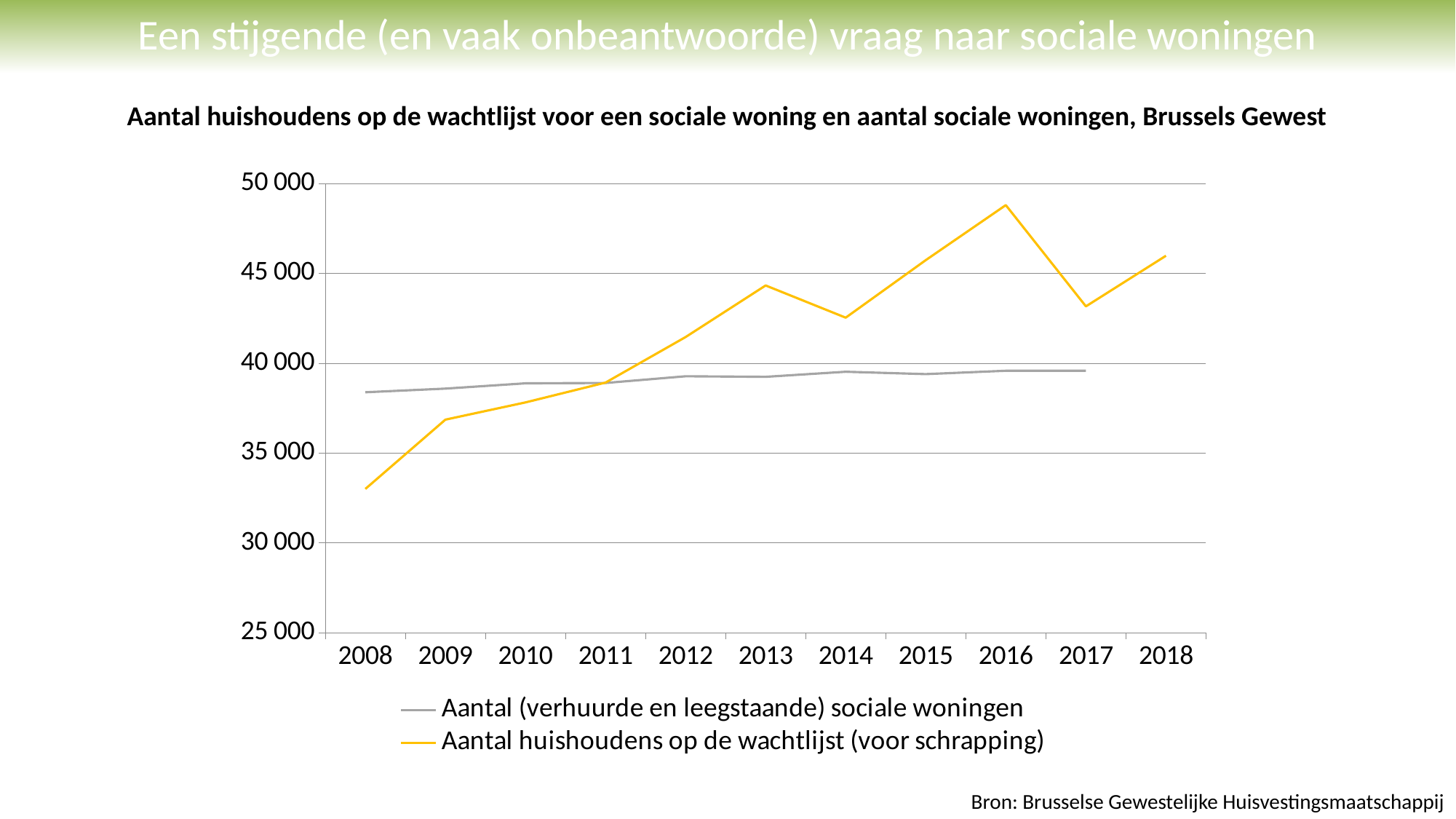
In 2008, which series has the larger value: 'Aantal (verhuurde en leegstaande) sociale woningen' or 'Aantal huishoudens op de wachtlijst (voor schrapping)'? Aantal (verhuurde en leegstaande) sociale woningen Is the value for 'Aantal huishoudens op de wachtlijst (voor schrapping)' in 2008 greater or less than 35 000? less What is the source cited for the chart? Brusselse Gewestelijke Huisvestingsmaatschappij Is the value for 'Aantal huishoudens op de wachtlijst (voor schrapping)' in 2016 greater or less than 45 000? greater How many years are plotted along the x axis? 11 In which year is the series 'Aantal huishoudens op de wachtlijst (voor schrapping)' at its lowest? 2008 Does the series 'Aantal huishoudens op de wachtlijst (voor schrapping)' generally rise or fall from 2008 to 2018? rise In which year does the series 'Aantal huishoudens op de wachtlijst (voor schrapping)' reach its highest value? 2016 What kind of chart is shown on the slide? line chart How many series does the legend list? 2